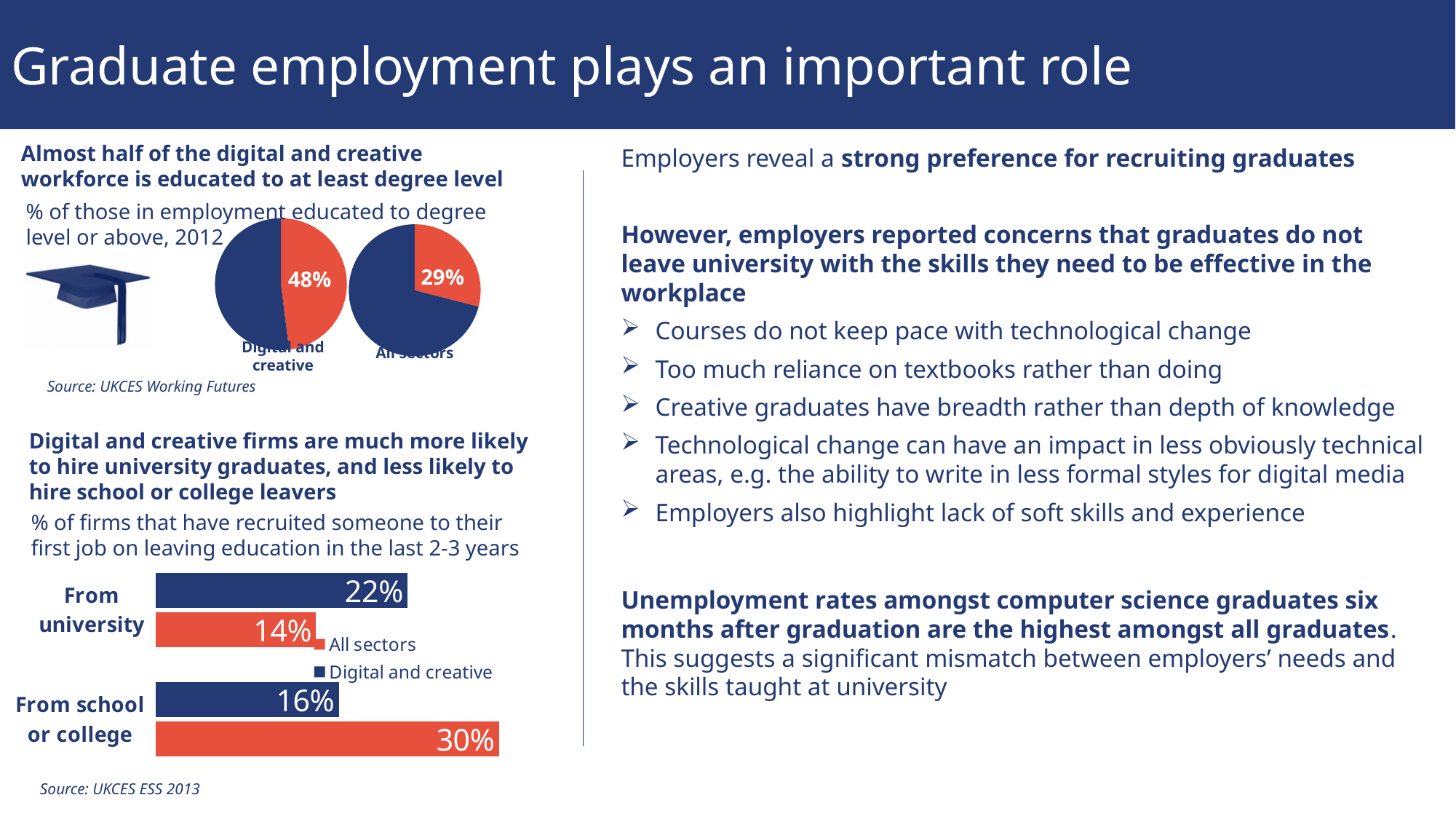
In the bar chart of firms recruiting to a first job, what is the value for Digital and creative firms recruiting from university? 22% How many series does the legend of the bar chart list? 2 In the pie chart labelled 'Digital and creative', what percentage of those in employment are educated to degree level or above? 48% In the bar chart of firms recruiting to a first job, what is the value for Digital and creative firms recruiting from school or college? 16% In the bar chart of firms recruiting to a first job, which bar has the highest value? All sectors, From school or college (30%) Comparing the two pie charts, which has the larger share educated to degree level or above, Digital and creative or All sectors? Digital and creative What is the difference in percentage points between the Digital and creative pie chart value and the All sectors pie chart value? 19 percentage points In the pie chart labelled 'All sectors', what percentage of those in employment are educated to degree level or above? 29% In the bar chart of firms recruiting to a first job, what is the value for All sectors recruiting from school or college? 30% In the bar chart of firms recruiting to a first job, what is the value for All sectors recruiting from university? 14% What type of chart is used to show the % of firms that have recruited someone to their first job on leaving education? Bar chart In the bar chart, what is the difference between the All sectors and Digital and creative values for recruiting from school or college? 14 percentage points